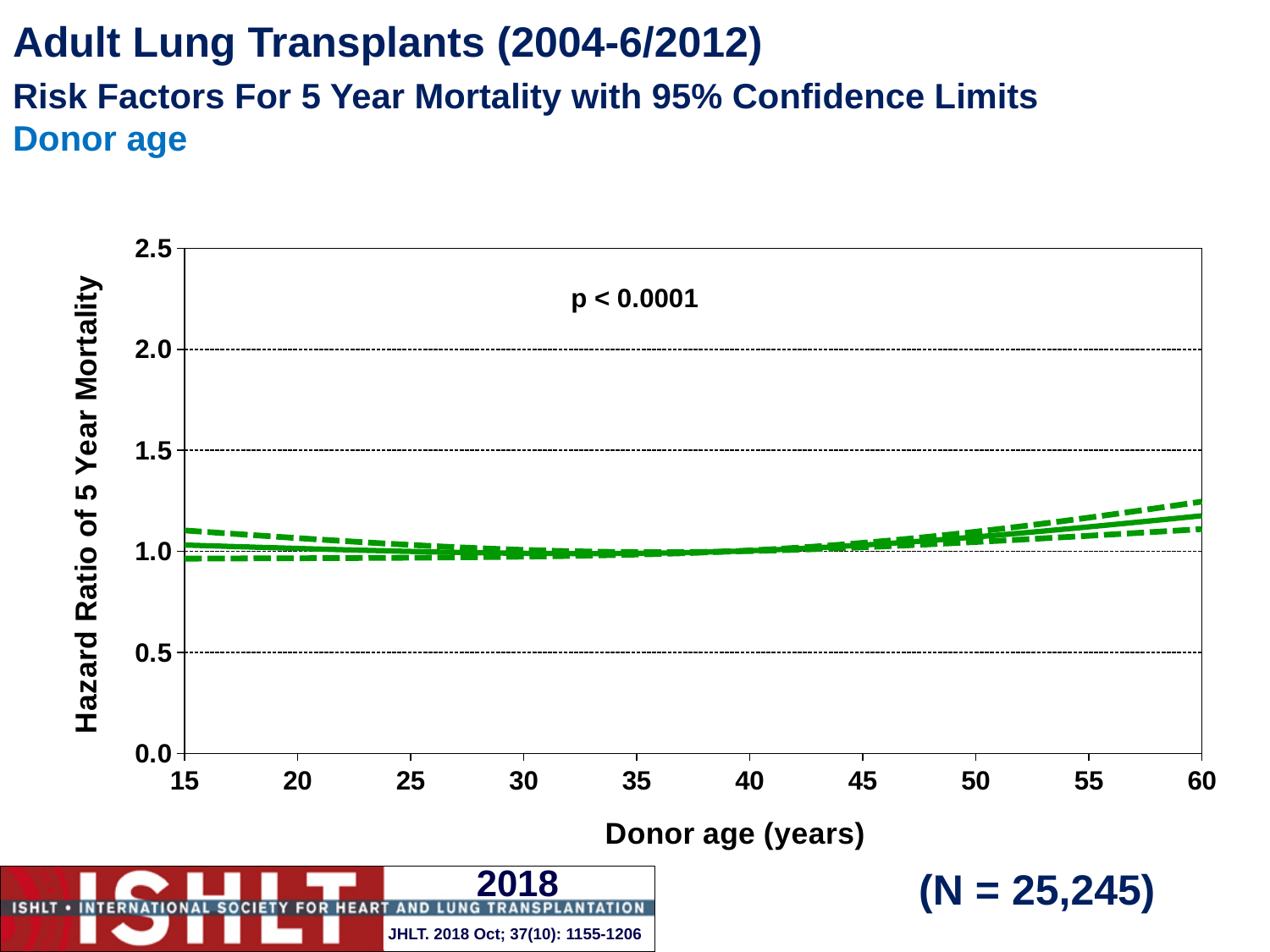
What is the label of the y axis? Hazard Ratio of 5 Year Mortality How many tick labels are shown on the x axis? 10 What p-value is printed on the chart? p < 0.0001 What is the label of the x axis? Donor age (years) Is the hazard ratio at a donor age of 60 years greater or less than 1.0? greater Does the hazard ratio rise or fall as donor age increases from 15 to 35 years? fall What sample size (N) is shown on the slide? N = 25,245 Is the hazard ratio at a donor age of 60 years greater or less than 1.5? less Does the hazard ratio rise or fall as donor age increases from 40 to 60 years? rise What is the highest value labelled on the y axis? 2.5 What kind of chart is shown on the slide? line chart Is the hazard ratio at a donor age of 35 years greater or less than 1.5? less